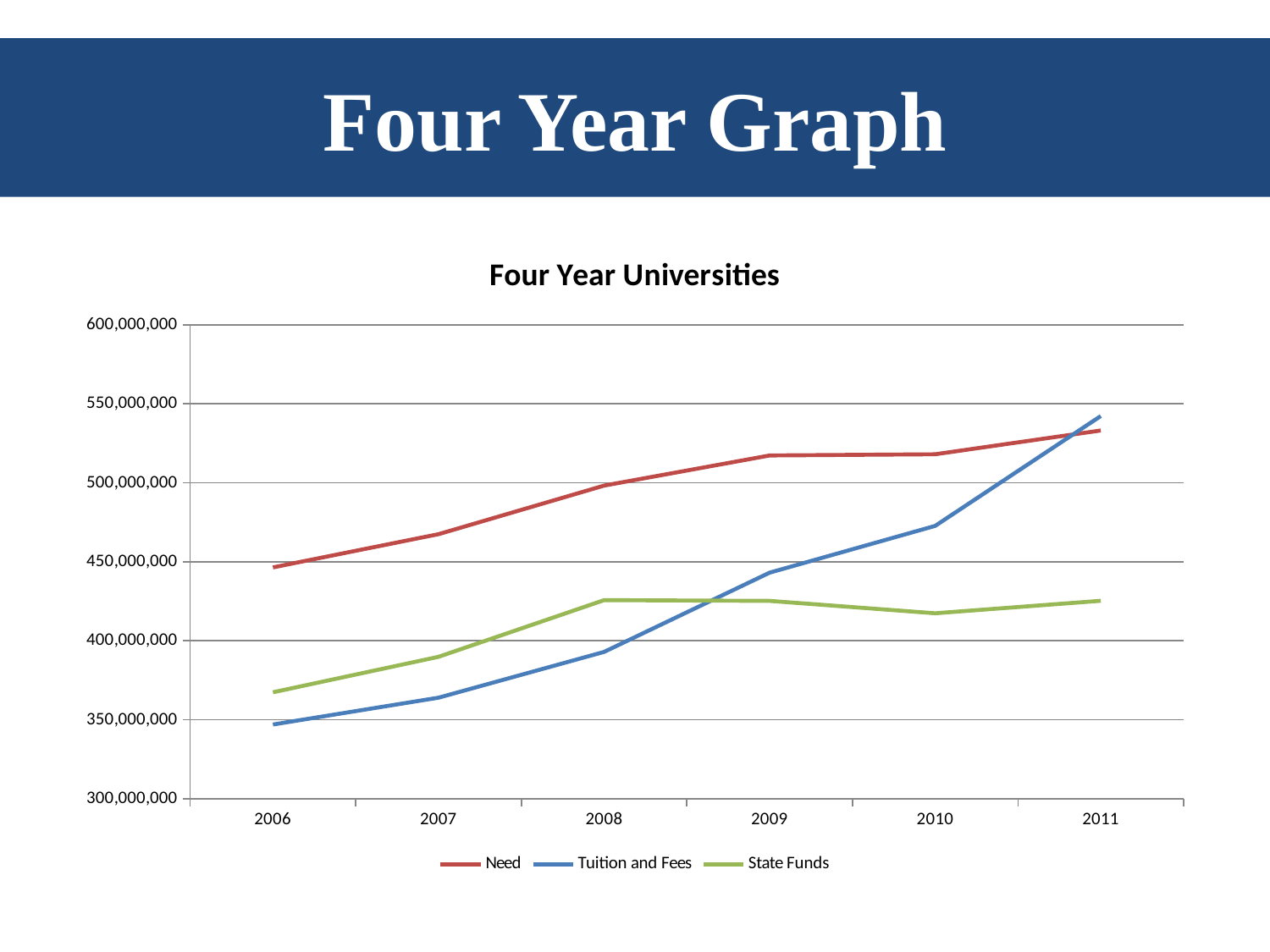
Is the value for State Funds in 2006 greater or less than 400,000,000? less Which series has the highest value in 2011? Tuition and Fees Does the Tuition and Fees line rise or fall from 2006 to 2011? rise What kind of chart is shown on the slide? line chart Is the value for Tuition and Fees in 2007 greater or less than 400,000,000? less In 2010, which is larger: Tuition and Fees or State Funds? Tuition and Fees Which series has the lowest value in 2006? Tuition and Fees How many series does the legend list? 3 How many years are plotted along the x axis? 6 Is the value for Tuition and Fees in 2011 greater or less than 500,000,000? greater What is the title of the chart? Four Year Universities